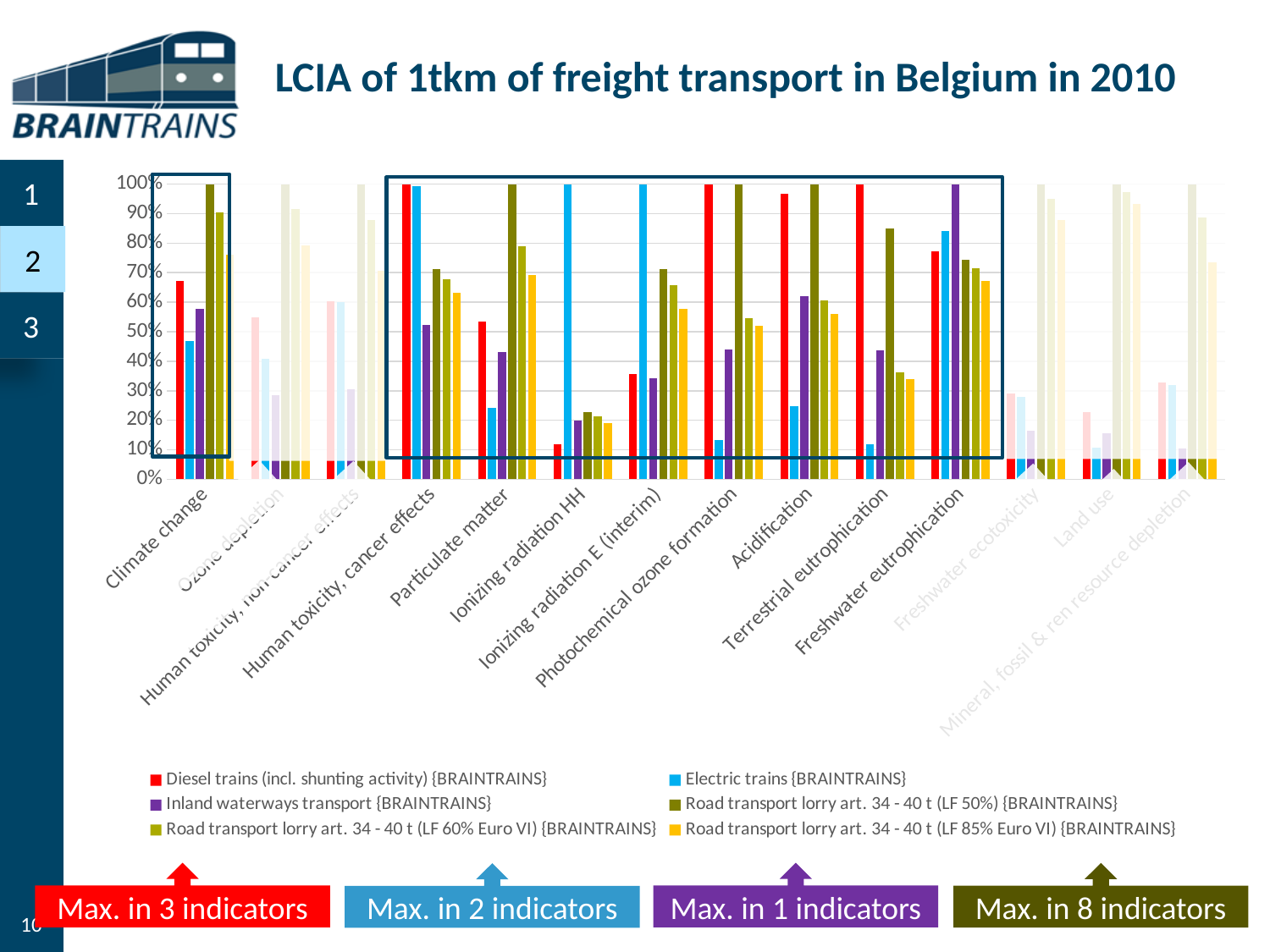
Which series has the highest value for Ionizing radiation HH? Electric trains {BRAINTRAINS} Is the value for Electric trains in Acidification greater or less than 30%? less What is the title of the chart? LCIA of 1tkm of freight transport in Belgium in 2010 Which series has the highest value for Freshwater eutrophication? Inland waterways transport {BRAINTRAINS} What kind of chart is shown on the slide? bar chart How many series does the legend list? 6 How many impact categories are shown along the x axis? 14 Which series has the lowest value for Climate change? Electric trains {BRAINTRAINS} Which series has the lowest value for Ionizing radiation HH? Diesel trains (incl. shunting activity) {BRAINTRAINS} Which series has the highest value for Climate change? Road transport lorry art. 34 - 40 t (LF 50%) {BRAINTRAINS} Is the value for Electric trains in Climate change greater or less than 50%? less For Climate change, which is larger: the value for Diesel trains or the value for Electric trains? Diesel trains